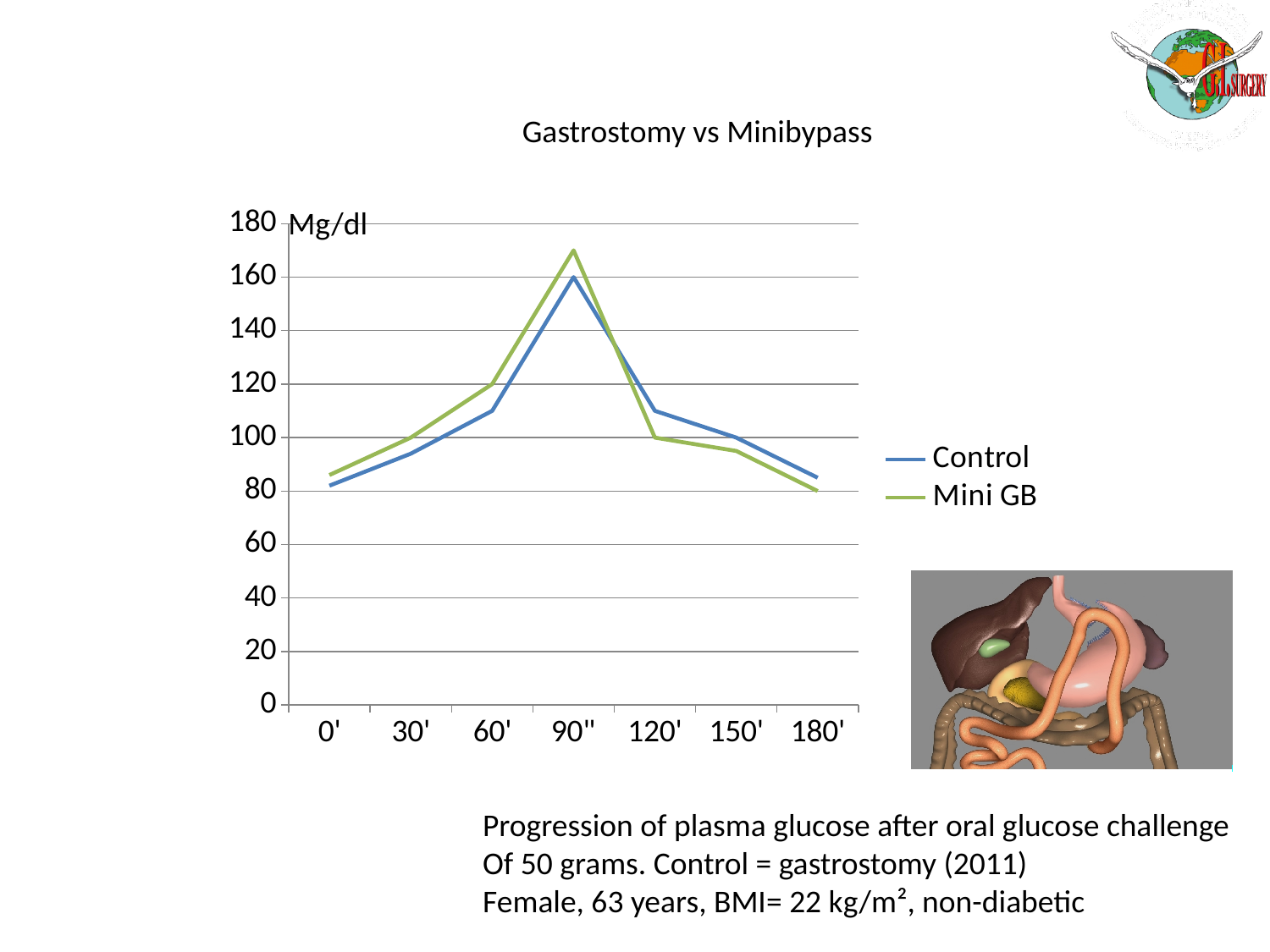
Is the Control value at 60' greater or less than 120? less What are the two series named in the legend? Control and Mini GB What kind of chart is shown on the slide? line chart At 90'', which series has the higher value, Control or Mini GB? Mini GB Is the Control value at 0' greater or less than 100? less At which time point does the Mini GB series reach its highest value? 90'' What is the title of the chart? Gastrostomy vs Minibypass How many series does the legend list? 2 Do the Control values rise or fall from 90'' to 180'? fall Is the Mini GB value at 90'' greater or less than 160? greater How many time points are plotted along the x axis? 7 At 120', which series has the higher value, Control or Mini GB? Control